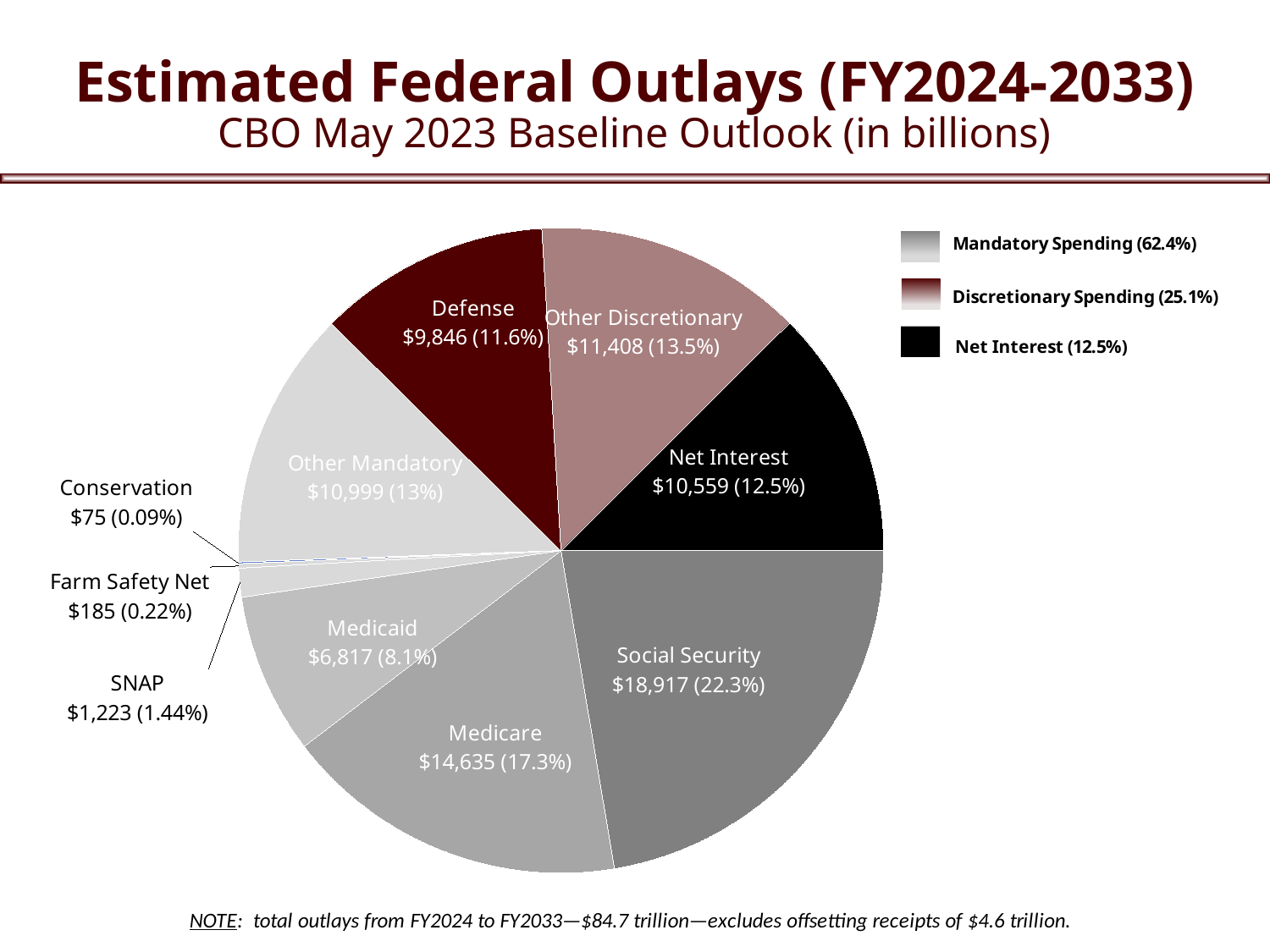
Which is larger, Medicare or Medicaid? Medicare How many slices does the pie chart have? 10 What is the estimated outlay for Defense? $9,846 What is the difference in billions between Social Security and Medicare outlays? $4,282 What is the estimated outlay for Farm Safety Net? $185 What is the difference in billions between Other Discretionary and Defense outlays? $1,562 According to the legend, what percentage of outlays is Mandatory Spending? 62.4% Which category has the smallest share of estimated federal outlays? Conservation What share of the pie does Medicaid represent? 8.1% Which category has the largest share of estimated federal outlays? Social Security What is the estimated outlay for Social Security? $18,917 What type of chart is shown on the slide? Pie chart